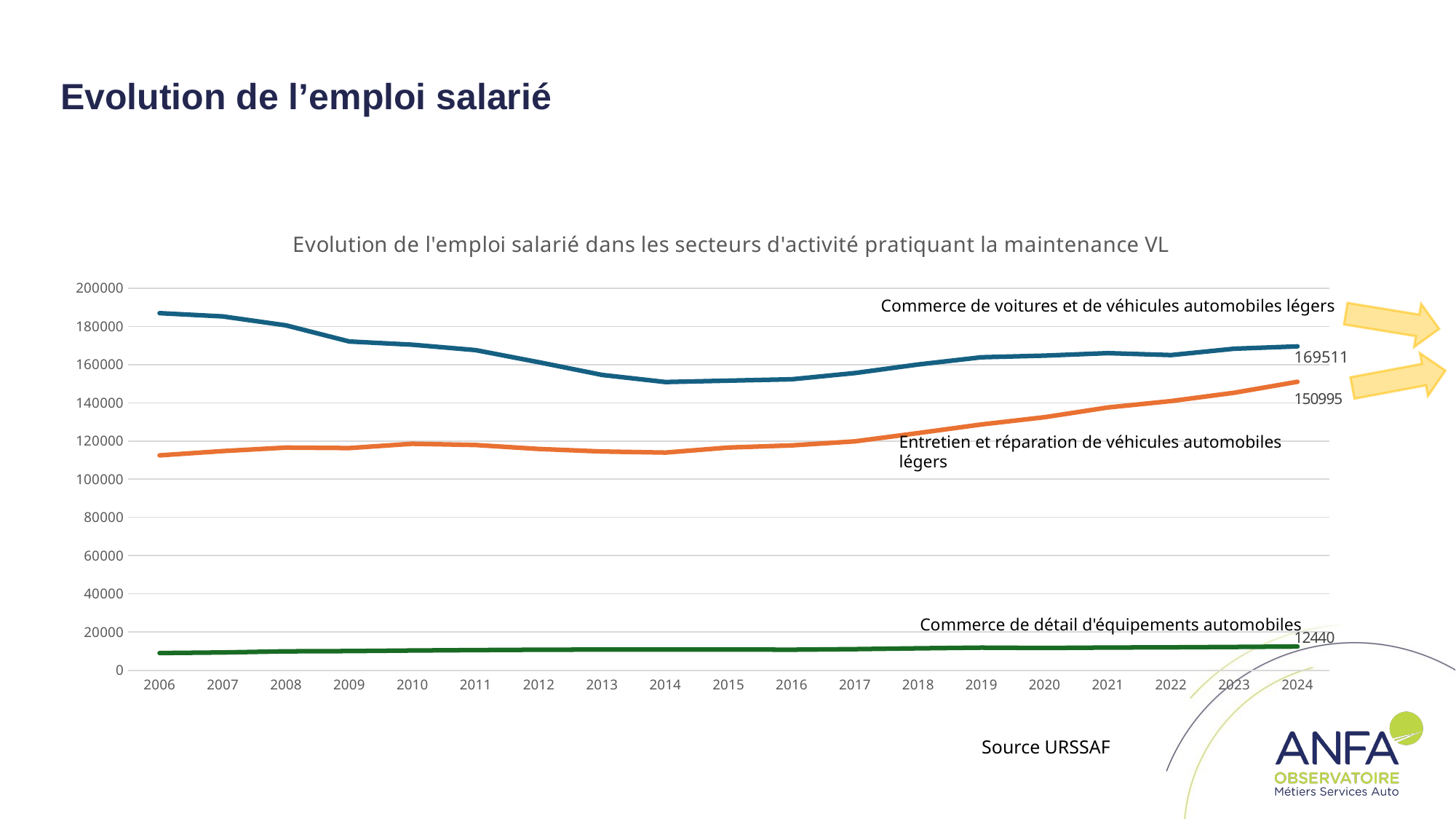
Does the Entretien et réparation de véhicules automobiles légers series rise or fall between 2014 and 2024? rise How many years are shown on the x axis? 19 Is the value for Commerce de voitures et de véhicules automobiles légers in 2014 greater or less than 160000? less Which series has the highest value in 2024? Commerce de voitures et de véhicules automobiles légers What kind of chart is shown on the slide? line chart Is the value for Commerce de voitures et de véhicules automobiles légers in 2006 greater or less than 180000? greater What is the difference between the 2024 values for Commerce de voitures et de véhicules automobiles légers and Entretien et réparation de véhicules automobiles légers? 18516 What is the value for Commerce de voitures et de véhicules automobiles légers in 2024? 169511 What is the value for Entretien et réparation de véhicules automobiles légers in 2024? 150995 Is the value for Entretien et réparation de véhicules automobiles légers in 2006 greater or less than 120000? less What is the value for Commerce de détail d'équipements automobiles in 2024? 12440 Which series has the lowest value in 2024? Commerce de détail d'équipements automobiles